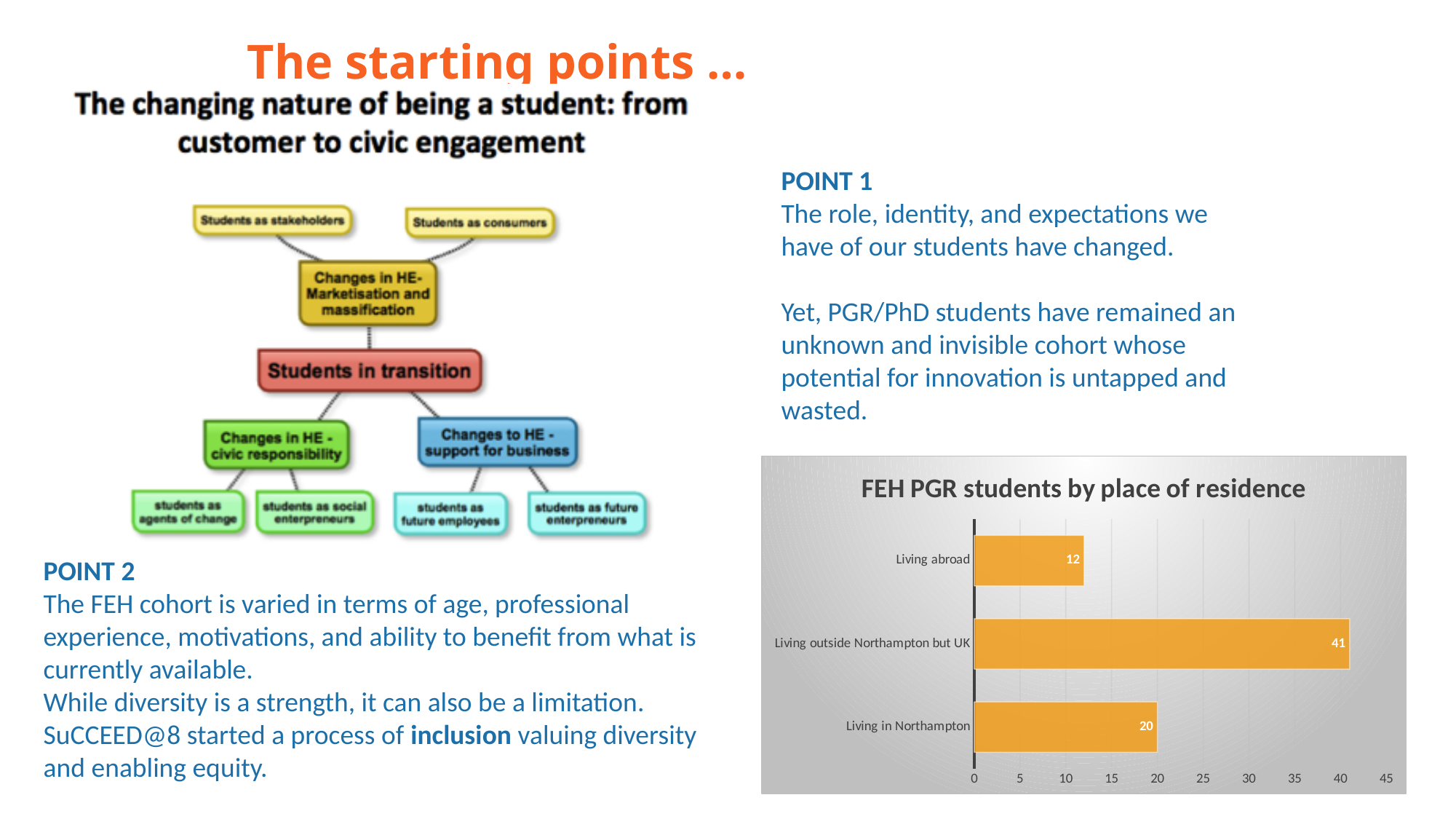
In the FEH PGR students chart, which is larger: Living in Northampton or Living abroad? Living in Northampton How many place of residence categories are shown in the FEH PGR students chart? 3 Which place of residence category has the lowest value in the FEH PGR students chart? Living abroad Which place of residence category has the highest value in the FEH PGR students chart? Living outside Northampton but UK What is the difference between the values for Living outside Northampton but UK and Living in Northampton in the FEH PGR students chart? 21 What kind of chart is the FEH PGR students by place of residence chart? bar chart What is the value for Living abroad in the FEH PGR students by place of residence chart? 12 What is the title of the chart on the slide? FEH PGR students by place of residence What is the value for Living outside Northampton but UK in the FEH PGR students by place of residence chart? 41 Is the value for Living outside Northampton but UK greater or less than 35 in the FEH PGR students chart? greater What is the value for Living in Northampton in the FEH PGR students by place of residence chart? 20 What is the difference between the values for Living in Northampton and Living abroad in the FEH PGR students chart? 8